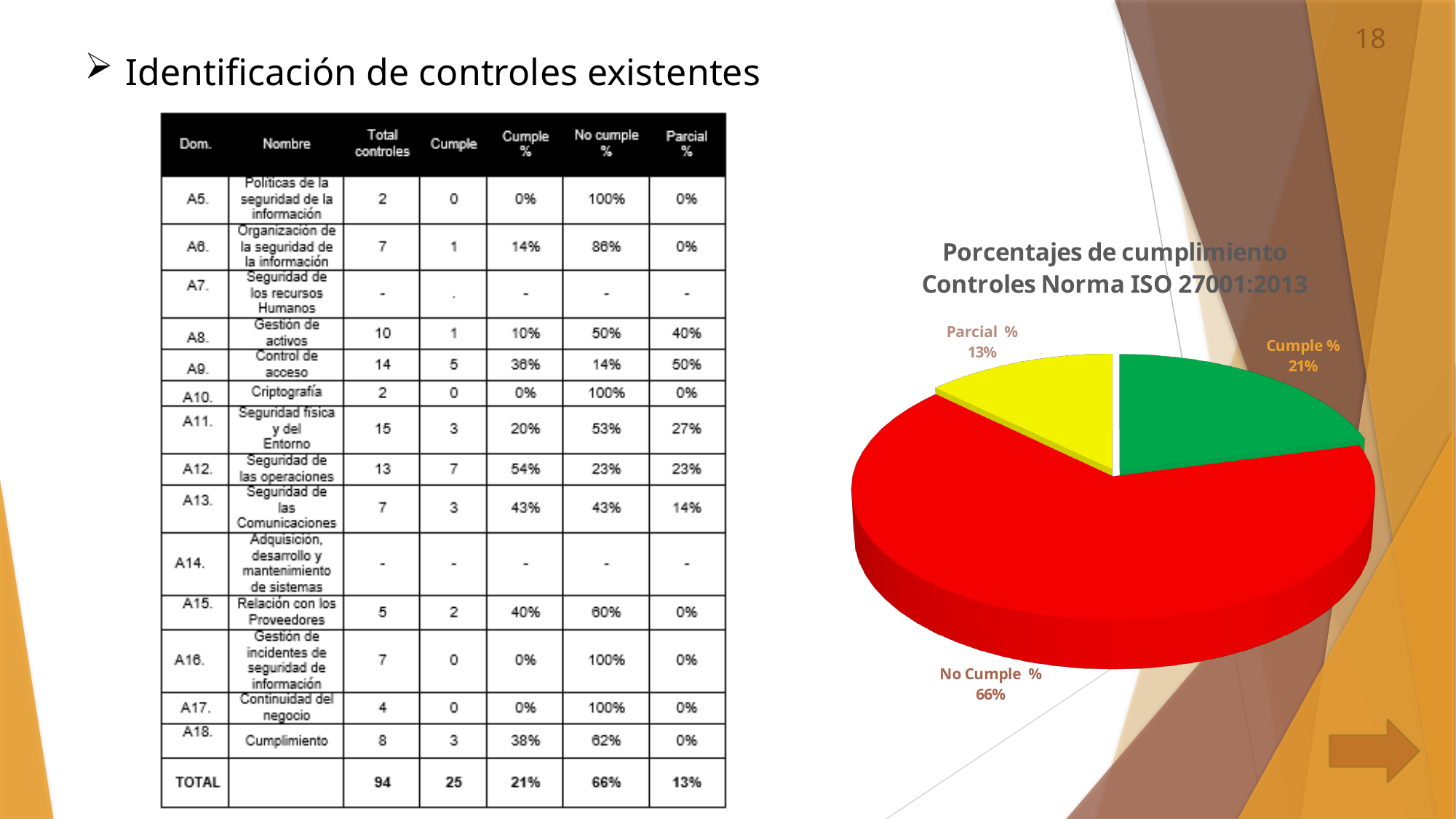
What type of chart is shown on the slide? pie chart What is the value of the Parcial % slice in the pie chart? 13% Which slice of the pie chart is the smallest? Parcial % Which is larger in the pie chart, Cumple % or Parcial %? Cumple % What colour is the No Cumple % slice in the pie chart? red What is the title of the pie chart? Porcentajes de cumplimiento Controles Norma ISO 27001:2013 What is the value of the Cumple % slice in the pie chart? 21% What is the difference between the No Cumple % slice and the Cumple % slice in the pie chart? 45% What is the difference between the Cumple % slice and the Parcial % slice in the pie chart? 8% Which slice of the pie chart is the largest? No Cumple % How many slices does the pie chart have? 3 What is the value of the No Cumple % slice in the pie chart? 66%